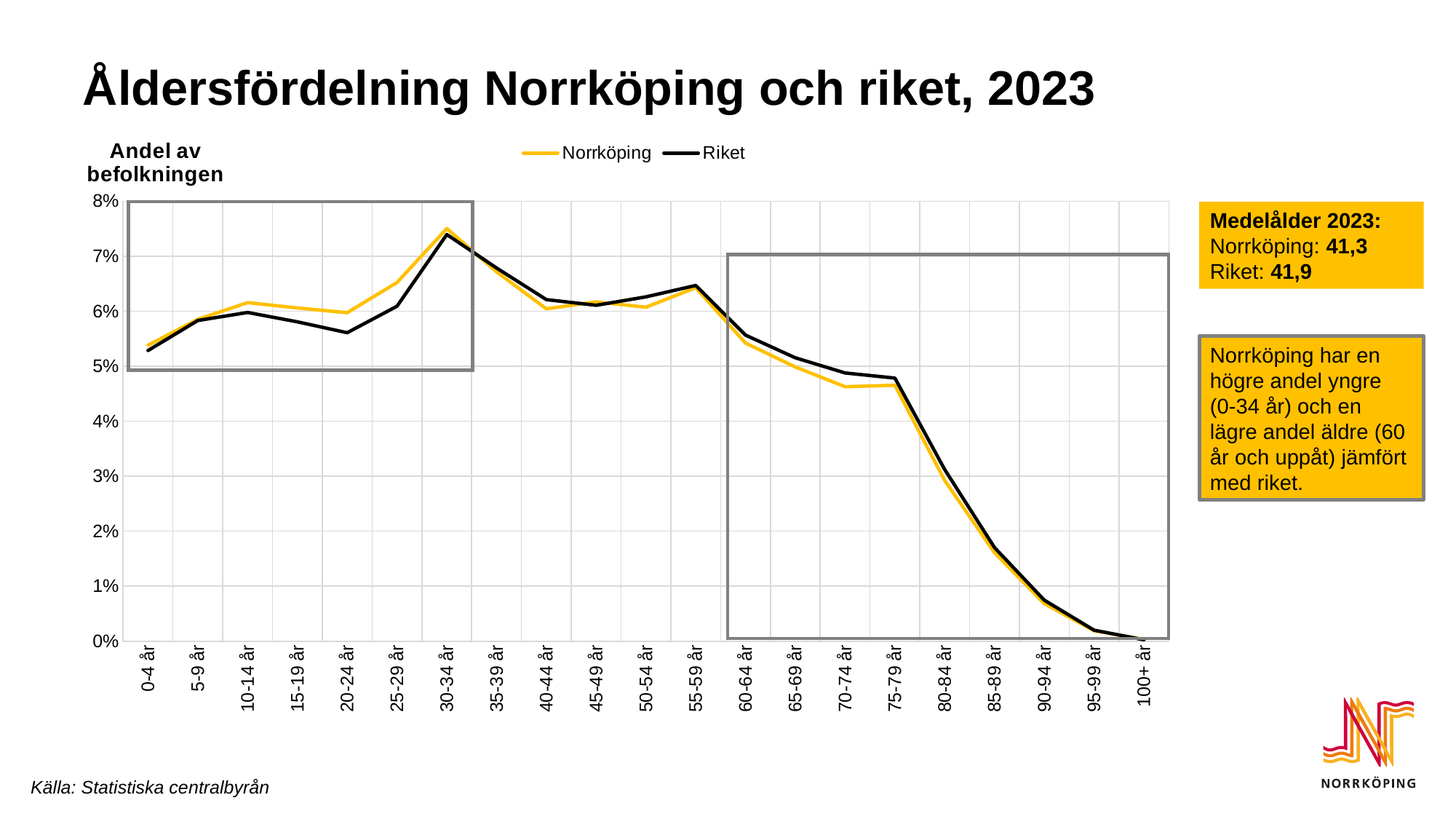
Which age group has the highest value for Riket? 30-34 år Which age group has the highest value for Norrköping? 30-34 år Is the value for Norrköping at 70-74 år greater or less than 5%? less Is the value for Norrköping at 30-34 år greater or less than 7%? greater What kind of chart is shown on the slide? line chart At 20-24 år, which series has the higher value, Norrköping or Riket? Norrköping How many age groups are shown on the x axis? 21 Which age group has the lowest value for Norrköping? 100+ år At 65-69 år, which series has the higher value, Norrköping or Riket? Riket Is the value for Riket at 20-24 år greater or less than 6%? less From 75-79 år to 100+ år, do the values rise or fall along the x axis? fall How many series does the legend list? 2